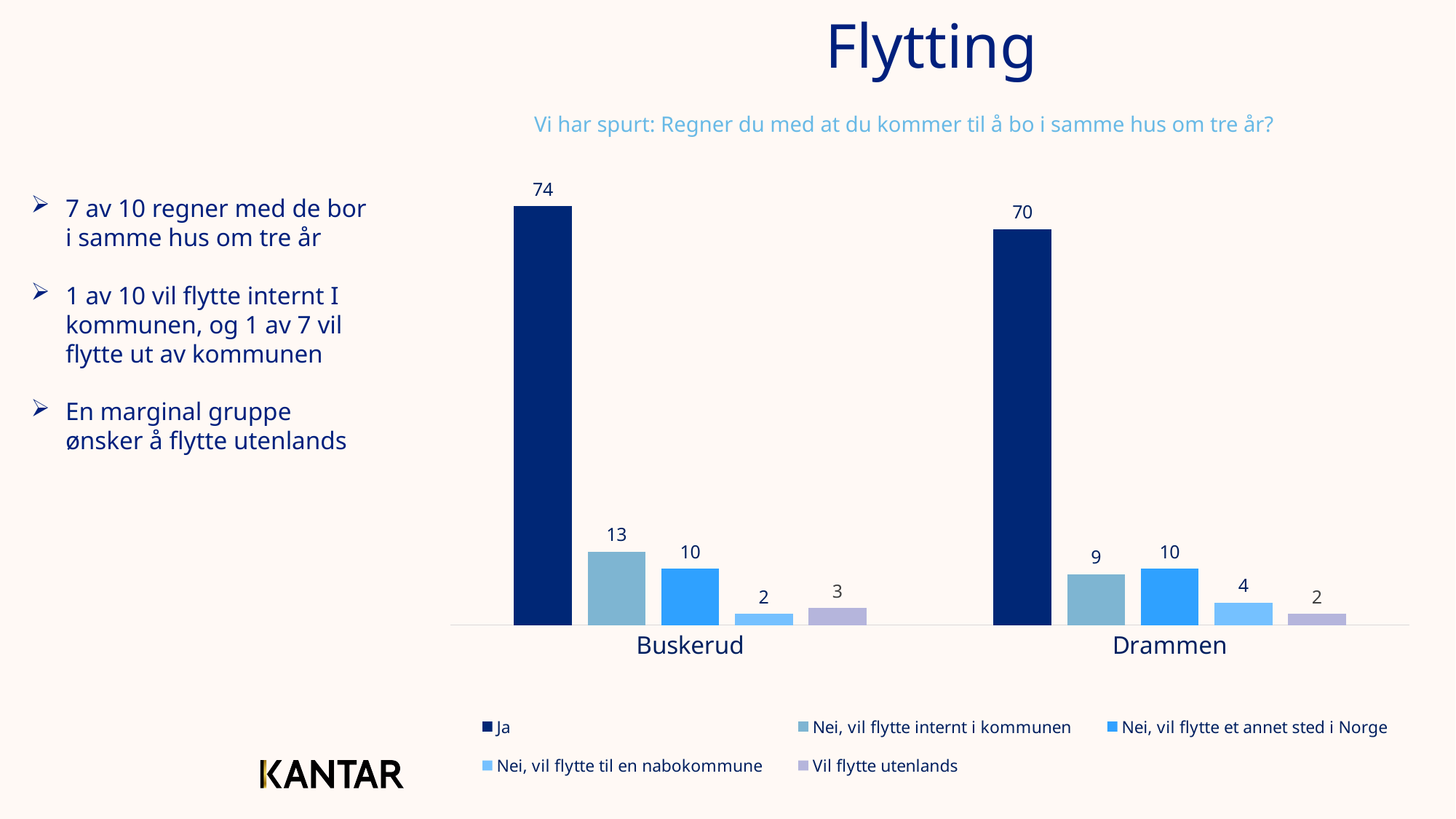
Which series has the lowest value in Buskerud? Nei, vil flytte til en nabokommune What is the value for "Vil flytte utenlands" in Buskerud? 3 Which is larger: "Nei, vil flytte internt i kommunen" in Buskerud or in Drammen? Buskerud What is the value for "Nei, vil flytte internt i kommunen" in Buskerud? 13 What kind of chart is shown on the slide? Bar chart What is the total of all five values for Drammen? 95 What is the difference between the "Ja" values for Buskerud and Drammen? 4 How many series does the legend list? 5 What is the value for "Ja" in Buskerud? 74 What is the value for "Ja" in Drammen? 70 Which series has the highest value in Drammen? Ja What is the value for "Nei, vil flytte til en nabokommune" in Drammen? 4